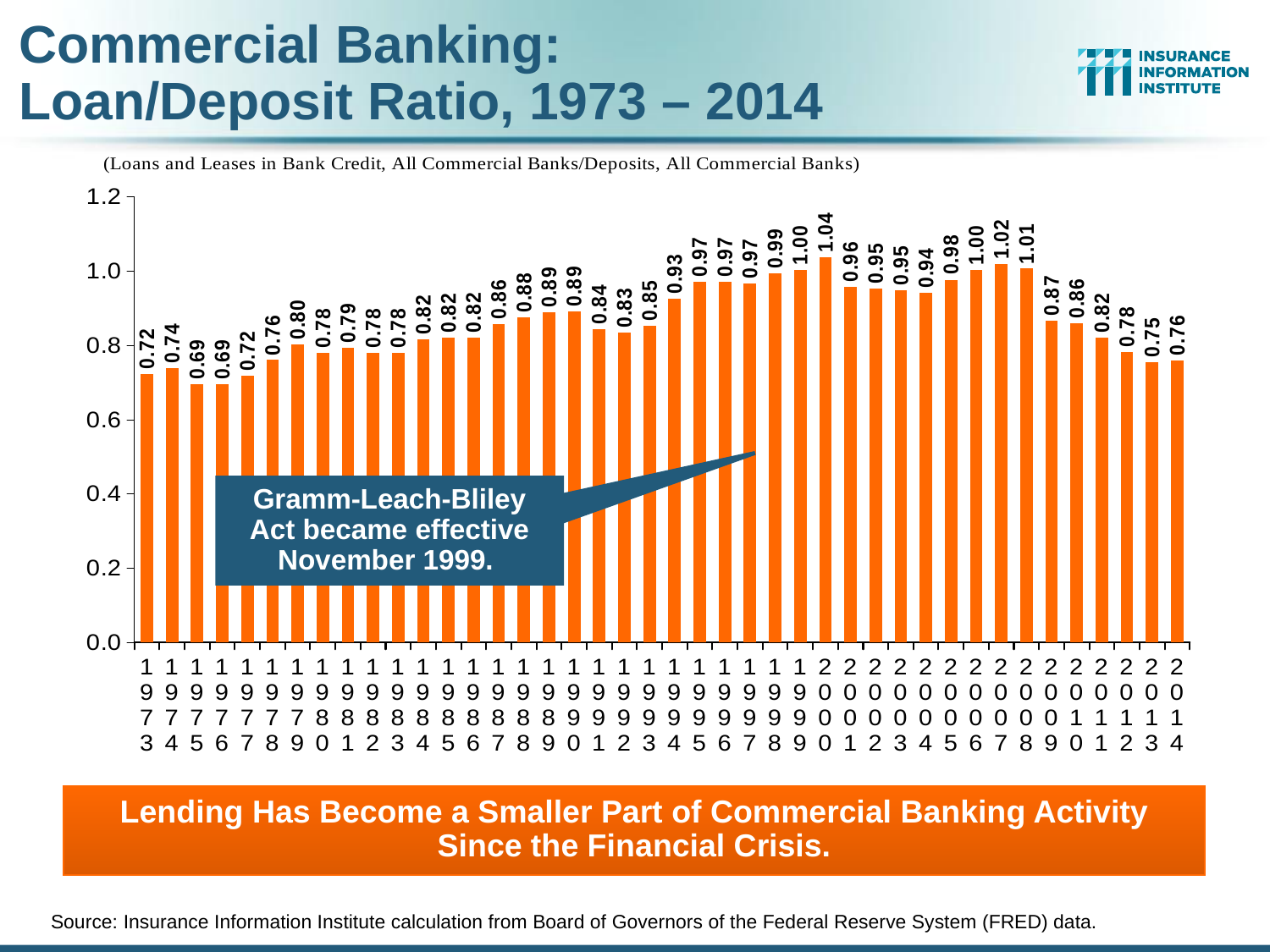
How many years (bars) are plotted on the chart? 42 What is the lowest loan/deposit ratio value shown on the chart? 0.69 According to the callout on the chart, when did the Gramm-Leach-Bliley Act become effective? November 1999 Did the loan/deposit ratio rise or fall from 2008 to 2013? Fall What is the loan/deposit ratio shown for 2000? 1.04 What is the loan/deposit ratio shown for 2008? 1.01 What is the loan/deposit ratio shown for 2014? 0.76 Which year has a higher loan/deposit ratio, 1999 or 2013? 1999 What is the loan/deposit ratio shown for 1973? 0.72 What kind of chart is shown on the slide? Bar chart What is the difference between the loan/deposit ratio in 2008 and in 2009? 0.14 Which year has the highest loan/deposit ratio? 2000